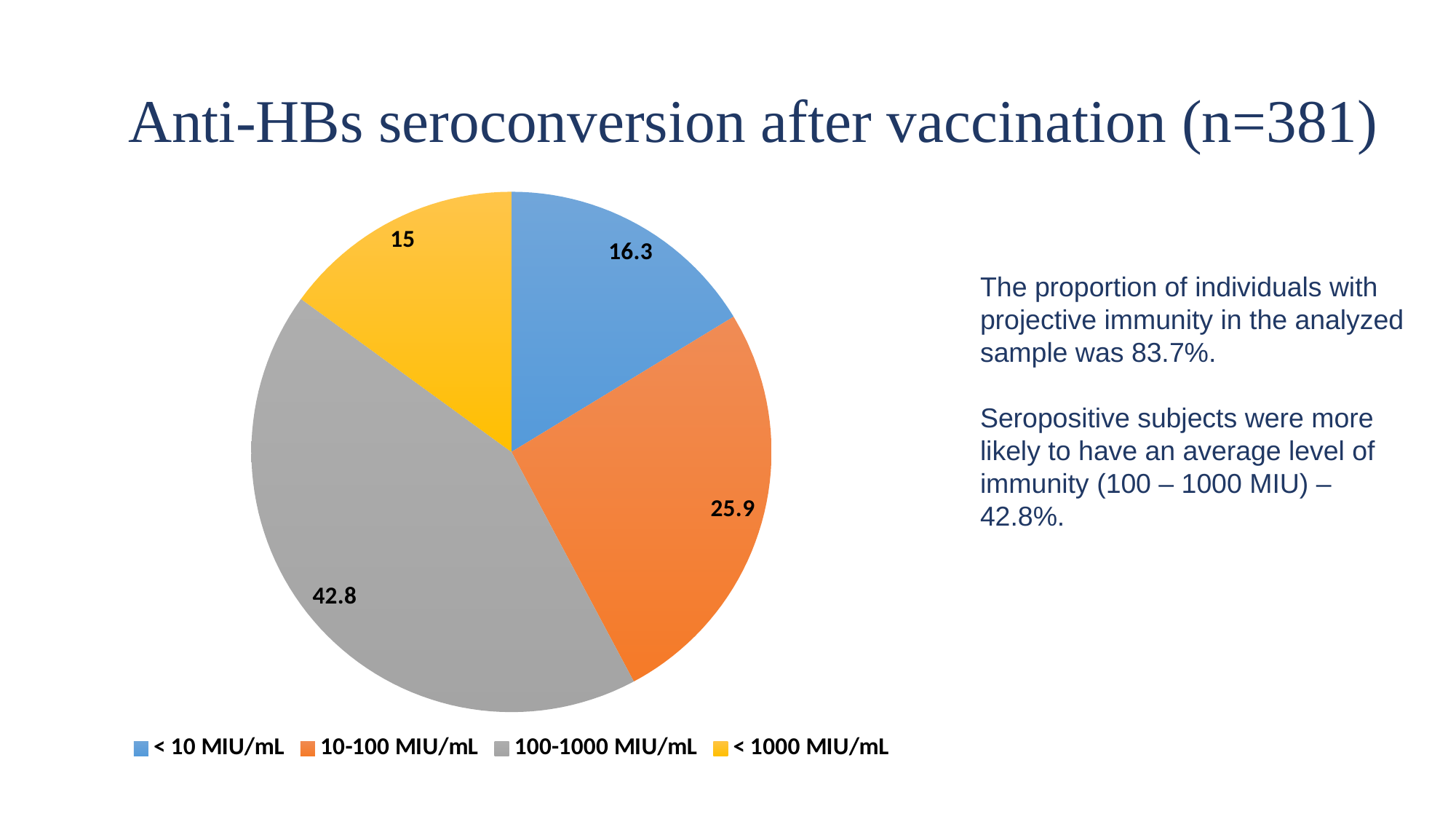
What is the difference between the 100-1000 MIU/mL value and the 10-100 MIU/mL value? 16.9 What kind of chart is shown on the slide? Pie chart What is the value for the < 10 MIU/mL slice? 16.3 What is the value for the 100-1000 MIU/mL slice? 42.8 What is the title of the slide containing the chart? Anti-HBs seroconversion after vaccination (n=381) How many slices does the pie chart have? 4 What is the value for the 10-100 MIU/mL slice? 25.9 Which category has the smallest slice? < 1000 MIU/mL What colour is the 100-1000 MIU/mL slice? Grey What is the value for the < 1000 MIU/mL slice? 15 Which category has the largest slice? 100-1000 MIU/mL Which is larger, the < 10 MIU/mL slice or the 10-100 MIU/mL slice? 10-100 MIU/mL